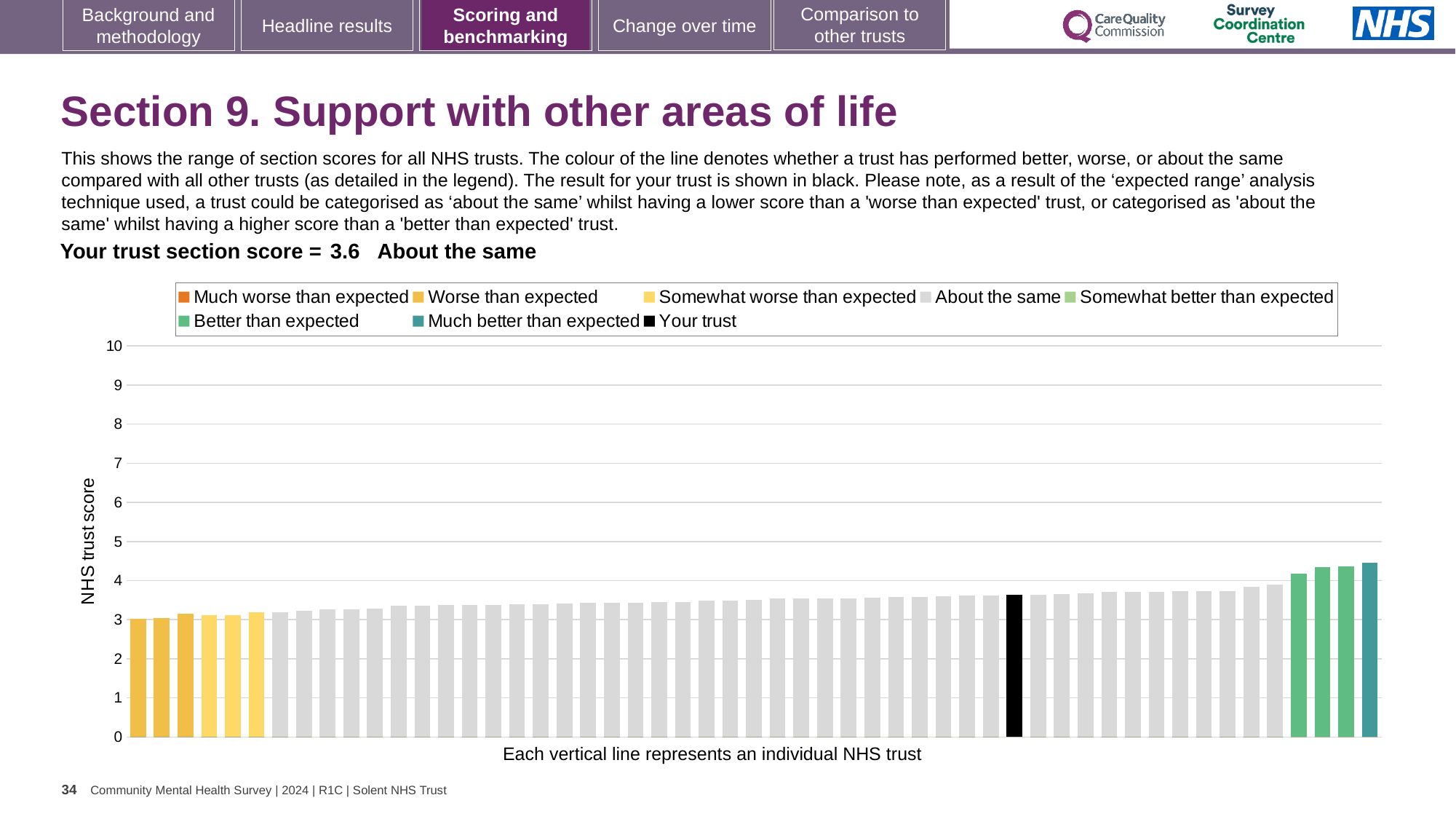
Which category is your trust placed in for this section? About the same What is the label on the vertical axis of the chart? NHS trust score Do the bar values rise or fall from left to right along the x axis? rise What is the section score for your trust shown on the slide? 3.6 Is the value of the tallest bar in the chart greater or less than 5? less How many bars are coloured teal (Much better than expected)? 1 Is the value of the tallest bar in the chart greater or less than 4? greater Is the value for your trust (the black bar) greater or less than 3? greater How many entries does the chart legend list? 8 What colour is the bar representing your trust? black What kind of chart is shown on the slide? bar chart